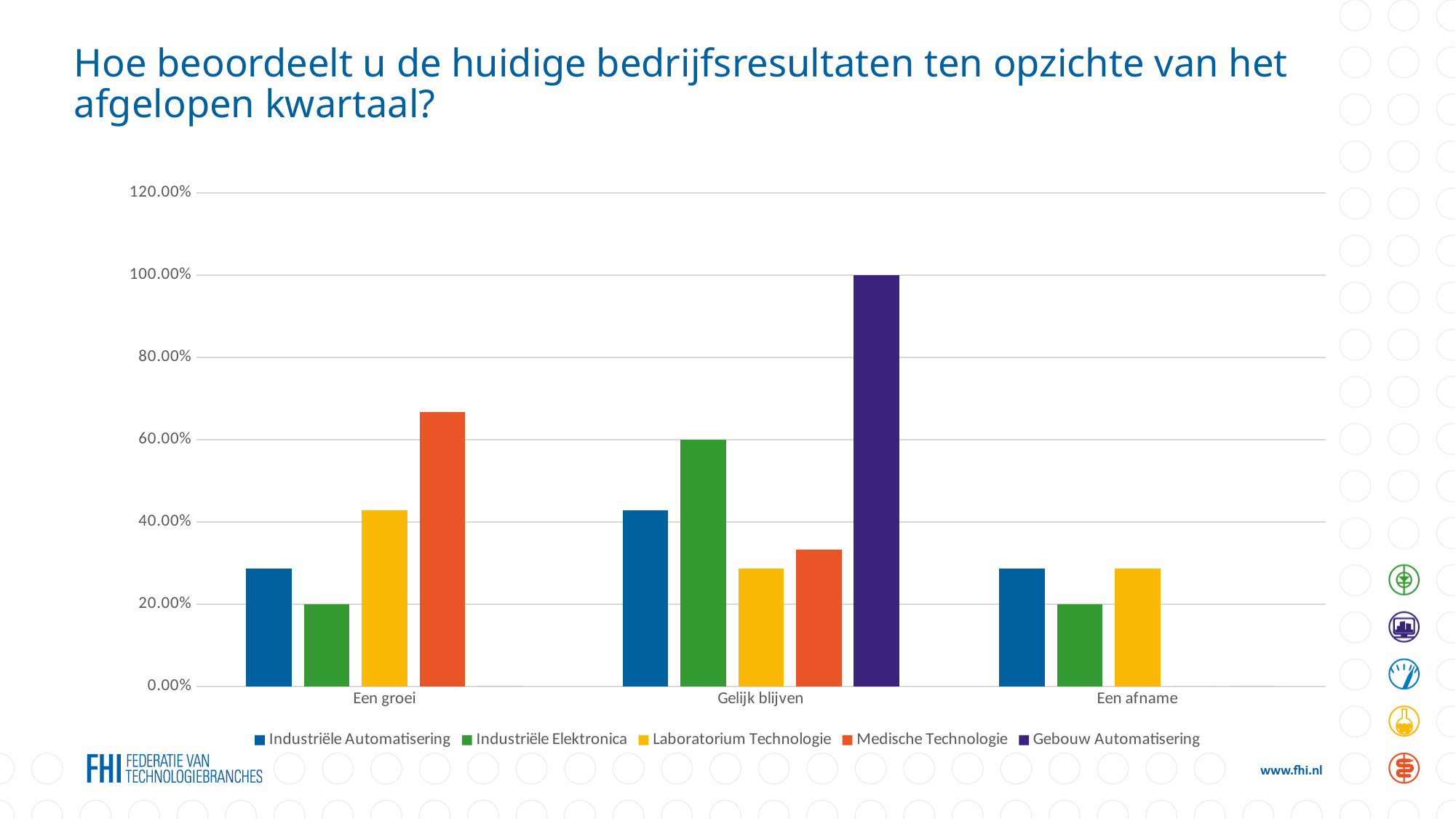
How many categories are shown on the x axis? 3 What kind of chart is shown on the slide? bar chart Which series is shown in purple in the legend? Gebouw Automatisering Is the value for Industriële Automatisering in the Een afname category greater or less than 40.00%? less What is the value for Industriële Elektronica in the Een groei category? 20.00% In the Gelijk blijven category, which is larger: Industriële Automatisering or Medische Technologie? Industriële Automatisering Which series has the highest value in the Gelijk blijven category? Gebouw Automatisering Is the value for Medische Technologie in the Een groei category greater or less than 60.00%? greater Which series has the highest value in the Een groei category? Medische Technologie How many series does the legend list? 5 What is the value for Industriële Elektronica in the Gelijk blijven category? 60.00% What is the value for Gebouw Automatisering in the Gelijk blijven category? 100.00%